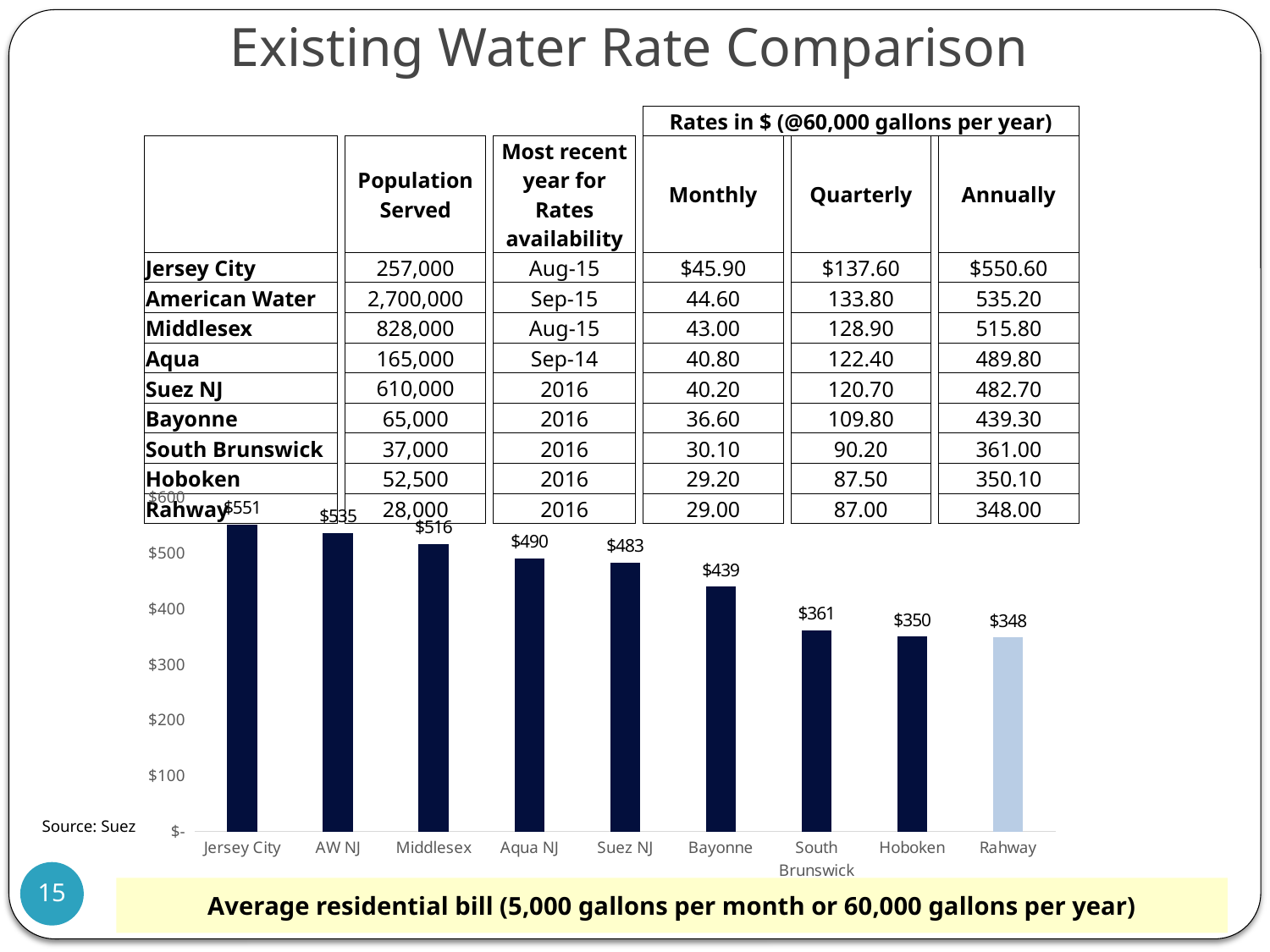
Do the bar values rise or fall from left to right along the x axis? fall Which category has the highest bar in the chart? Jersey City What is the value shown for South Brunswick in the bar chart? $361 What is the value shown for Jersey City in the bar chart? $551 What is the difference between the values for Jersey City and Rahway in the bar chart? $203 In the bar chart, which is larger, the value for Aqua NJ or the value for Suez NJ? Aqua NJ What is the value shown for Bayonne in the bar chart? $439 What is the difference between the values for AW NJ and Middlesex in the bar chart? $19 Is the value for Hoboken in the bar chart greater or less than $400? less Which category has the lowest bar in the chart? Rahway How many categories are shown on the x axis of the bar chart? 9 What kind of chart is shown on the slide? bar chart